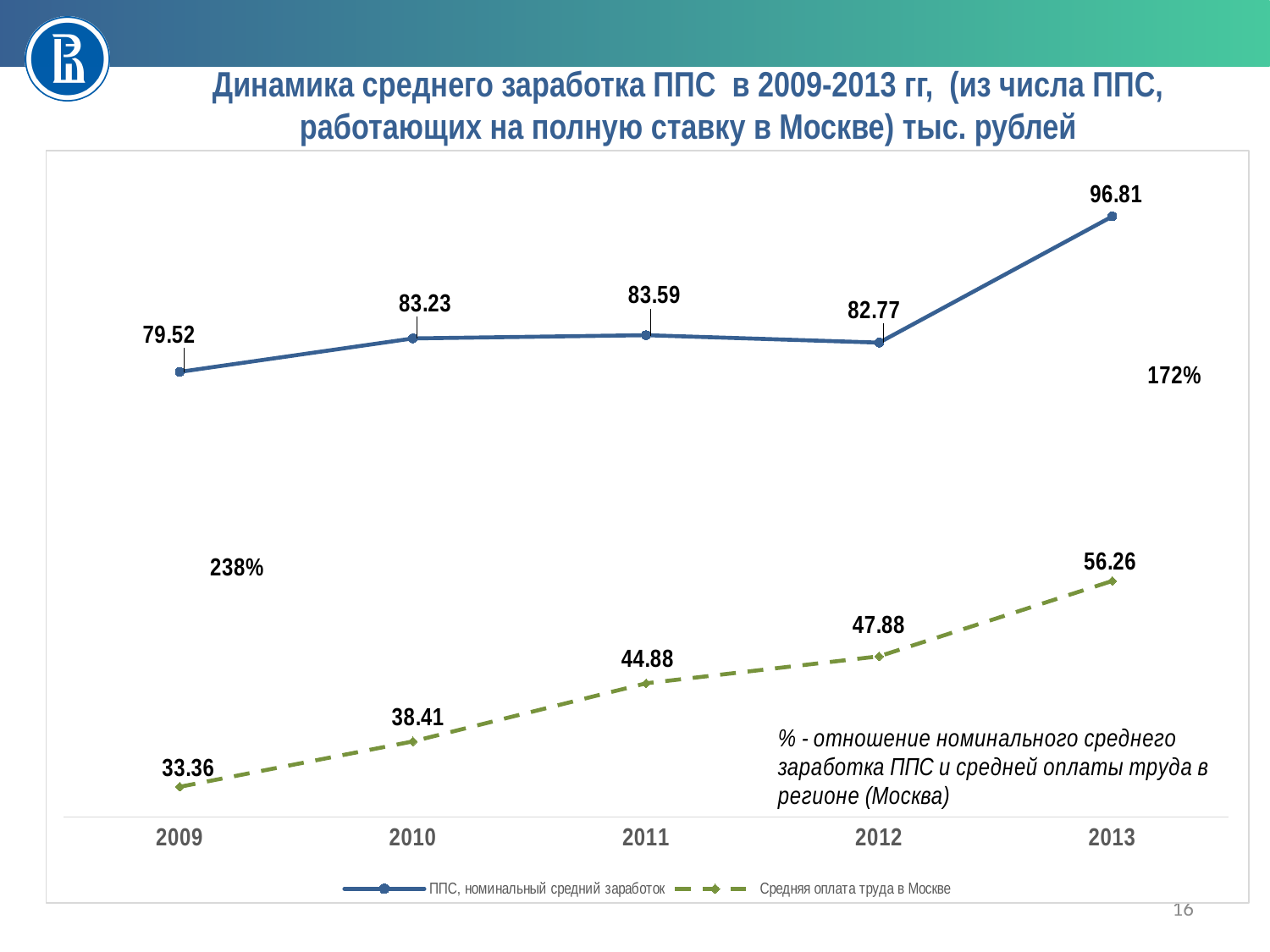
What is the value of 'ППС, номинальный средний заработок' in 2012? 82.77 In which year is 'ППС, номинальный средний заработок' highest? 2013 In which year is 'Средняя оплата труда в Москве' lowest? 2009 What percentage is annotated next to the 2013 data points? 172% How many series does the legend list? 2 Which is larger in 2011: 'ППС, номинальный средний заработок' or 'Средняя оплата труда в Москве'? ППС, номинальный средний заработок What is the value of 'Средняя оплата труда в Москве' in 2009? 33.36 Does 'Средняя оплата труда в Москве' rise or fall from 2009 to 2013? rise What type of chart is shown on the slide? line chart How many years are plotted along the x axis? 5 What is the value of 'ППС, номинальный средний заработок' in 2013? 96.81 What is the difference between 'ППС, номинальный средний заработок' and 'Средняя оплата труда в Москве' in 2013? 40.55